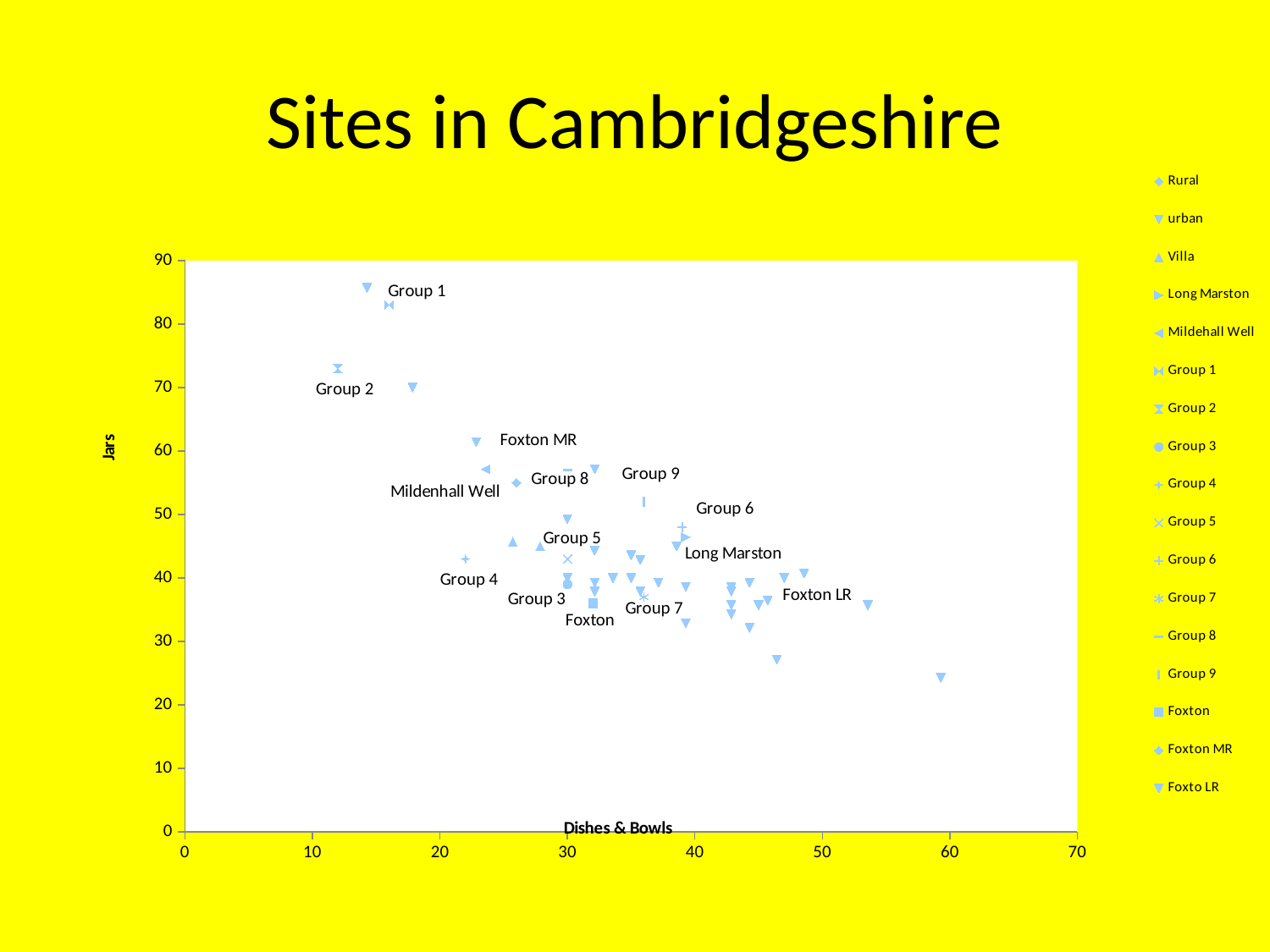
Is the Dishes & Bowls value for Group 2 greater or less than 20? less Is the Jars value for Group 1 greater or less than 80? greater Is the Jars value for Foxton greater or less than 40? less How many series does the legend list? 17 What is the label of the vertical axis? Jars Which has the higher Jars value, Group 1 or Group 2? Group 1 What is the title of the chart? Sites in Cambridgeshire Which of the labelled groups has the highest Jars value? Group 1 What kind of chart is shown on the slide? scatter chart